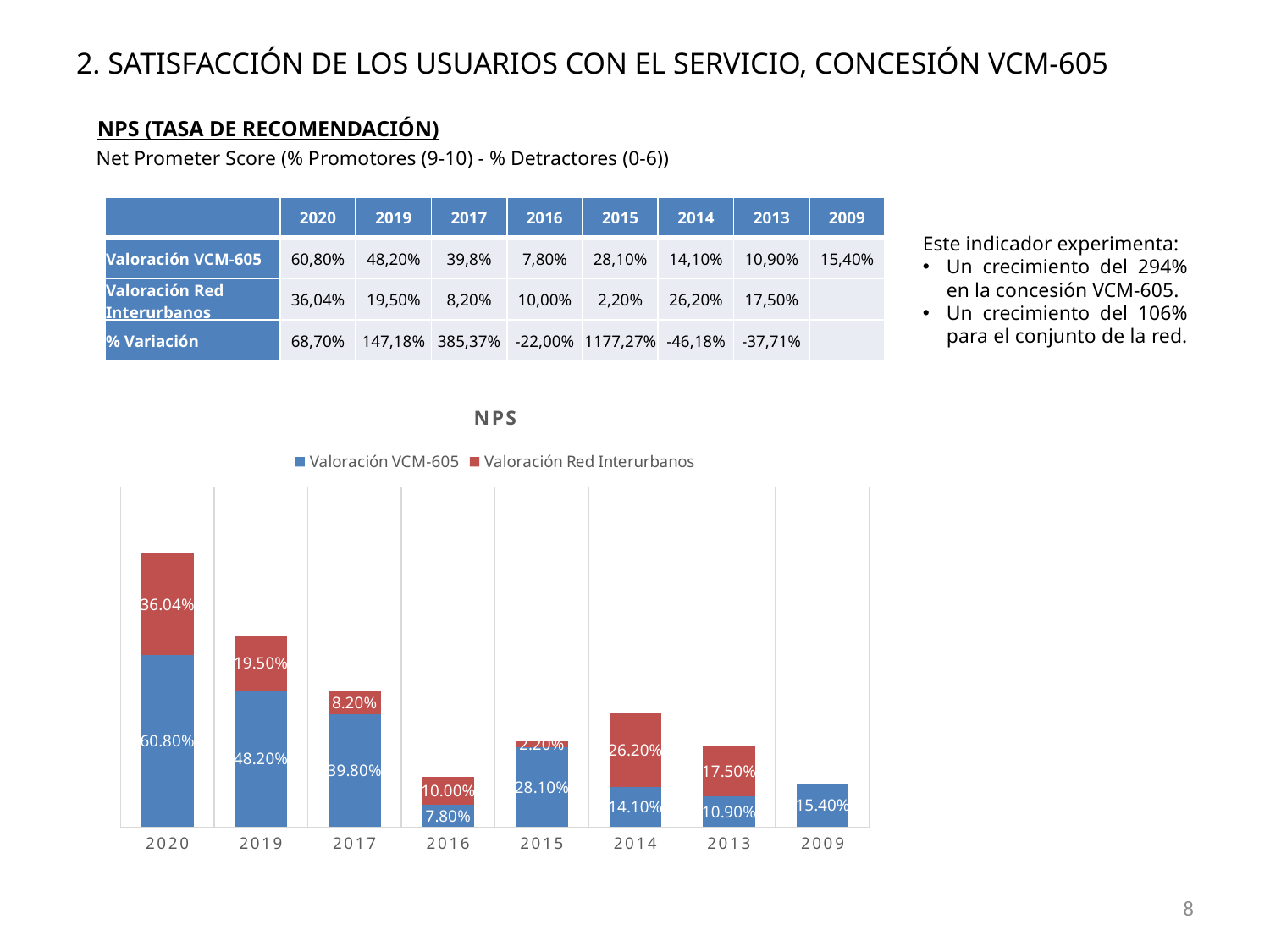
In the NPS chart, what is the total of the stacked bar for 2017? 48.00% In the NPS chart, which year has the lowest value for Valoración VCM-605? 2016 How many series does the legend of the NPS chart list? 2 In the NPS chart, what is the value of Valoración VCM-605 for 2020? 60.80% In the NPS chart, what is the difference between Valoración VCM-605 in 2020 and in 2019? 12.60% What kind of chart is the NPS chart? stacked bar chart In the NPS chart, which is larger for 2014: Valoración VCM-605 or Valoración Red Interurbanos? Valoración Red Interurbanos In the NPS chart, which year has the highest value for Valoración VCM-605? 2020 In the NPS chart, which year has the lowest value for Valoración Red Interurbanos? 2015 In the NPS chart, what is the value of Valoración Red Interurbanos for 2019? 19.50% In the NPS chart, what is the value of Valoración VCM-605 for 2009? 15.40% How many years are shown on the x axis of the NPS chart? 8